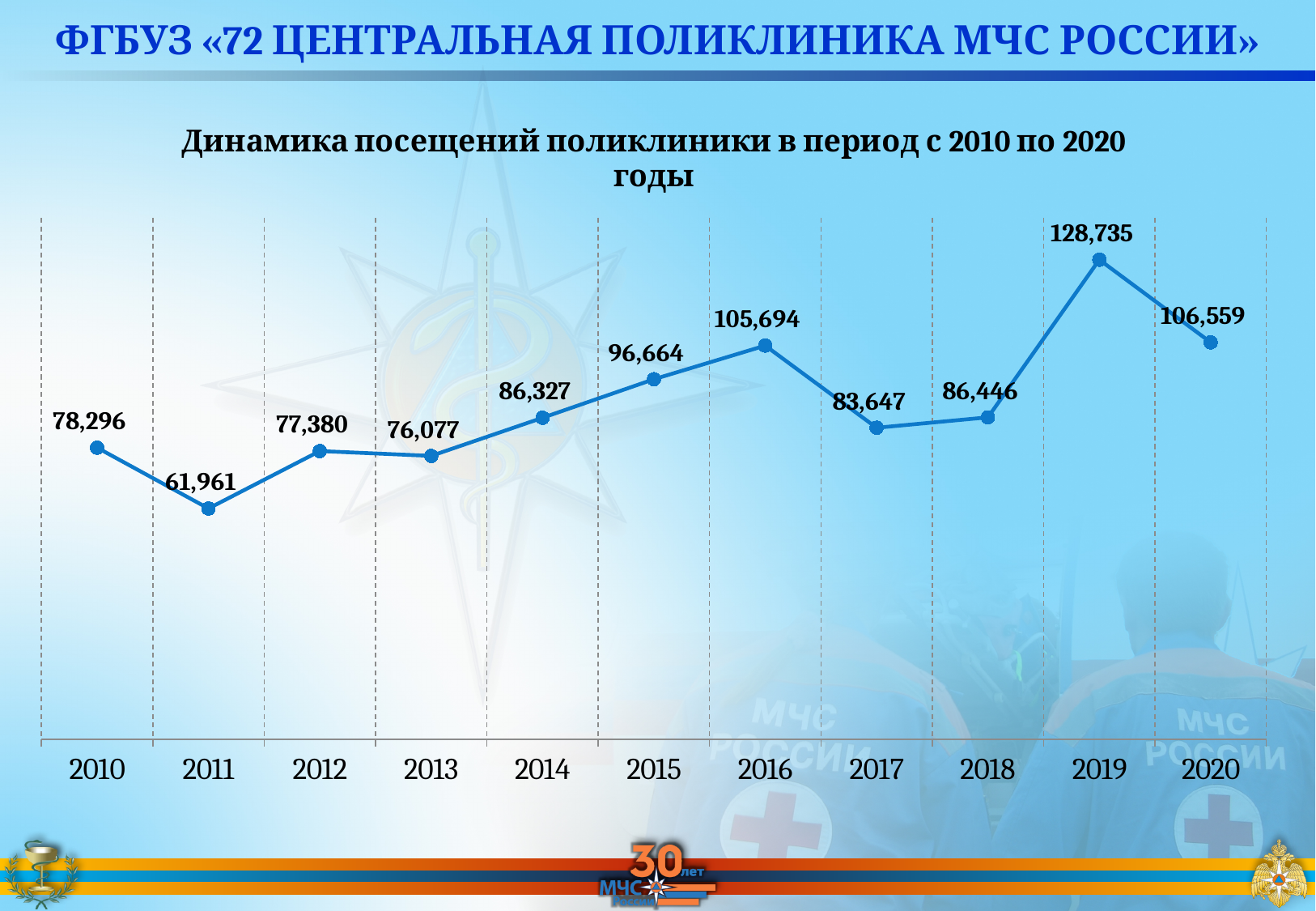
What is the difference between the values for 2016 and 2015? 9,030 Which year has the larger value, 2012 or 2013? 2012 Which year has the larger value, 2017 or 2018? 2018 Do the values rise or fall from 2013 to 2016? Rise What kind of chart is shown on the slide? Line chart What is the value shown for 2011? 61,961 How many years are plotted on the chart? 11 What is the number of polyclinic visits in 2016? 105,694 Which year has the highest number of visits? 2019 Which year has the lowest number of visits? 2011 What is the value shown for 2020? 106,559 What is the difference between the values for 2019 and 2020? 22,176